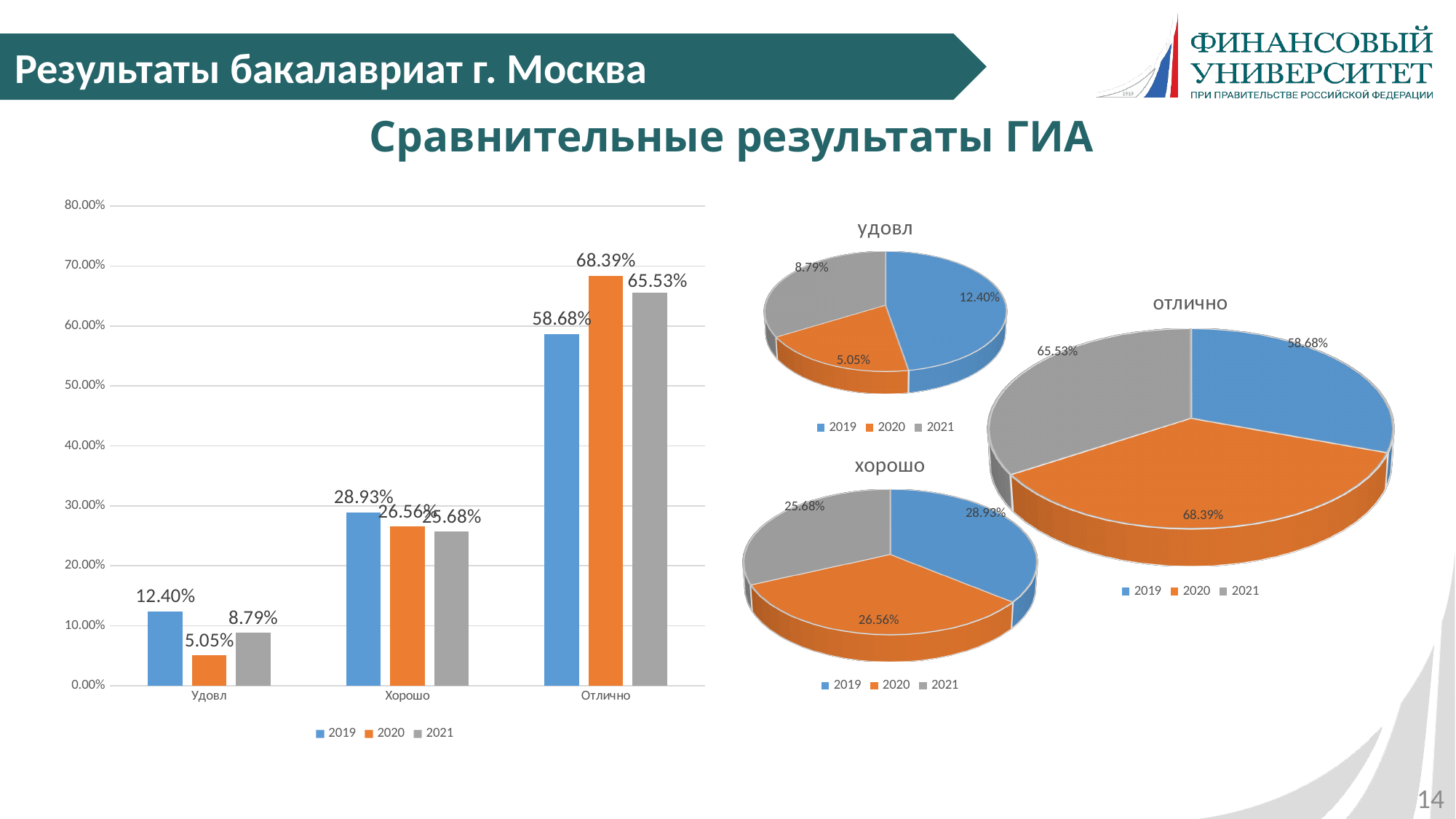
In the bar chart on the left, which year has the highest value in the Отлично category? 2020 In the bar chart on the left, how many categories are shown on the x axis? 3 In the bar chart on the left, which is larger: the 2019 value for Хорошо or the 2021 value for Хорошо? 2019 In the bar chart on the left, what is the value for 2021 in the Отлично category? 65.53% In the pie chart titled удовл, what is the share for 2021? 8.79% In the pie chart titled хорошо, what is the share for 2020? 26.56% In the bar chart on the left, what is the difference between the 2020 and 2019 values in the Отлично category? 9.71% In the pie chart titled отлично, which year has the largest slice? 2020 In the bar chart on the left, how many series does the legend list? 3 In the bar chart on the left, what is the value for 2020 in the Удовл category? 5.05% In the bar chart on the left, which year has the lowest value in the Удовл category? 2020 What type of chart is shown on the left side of the slide? Bar chart